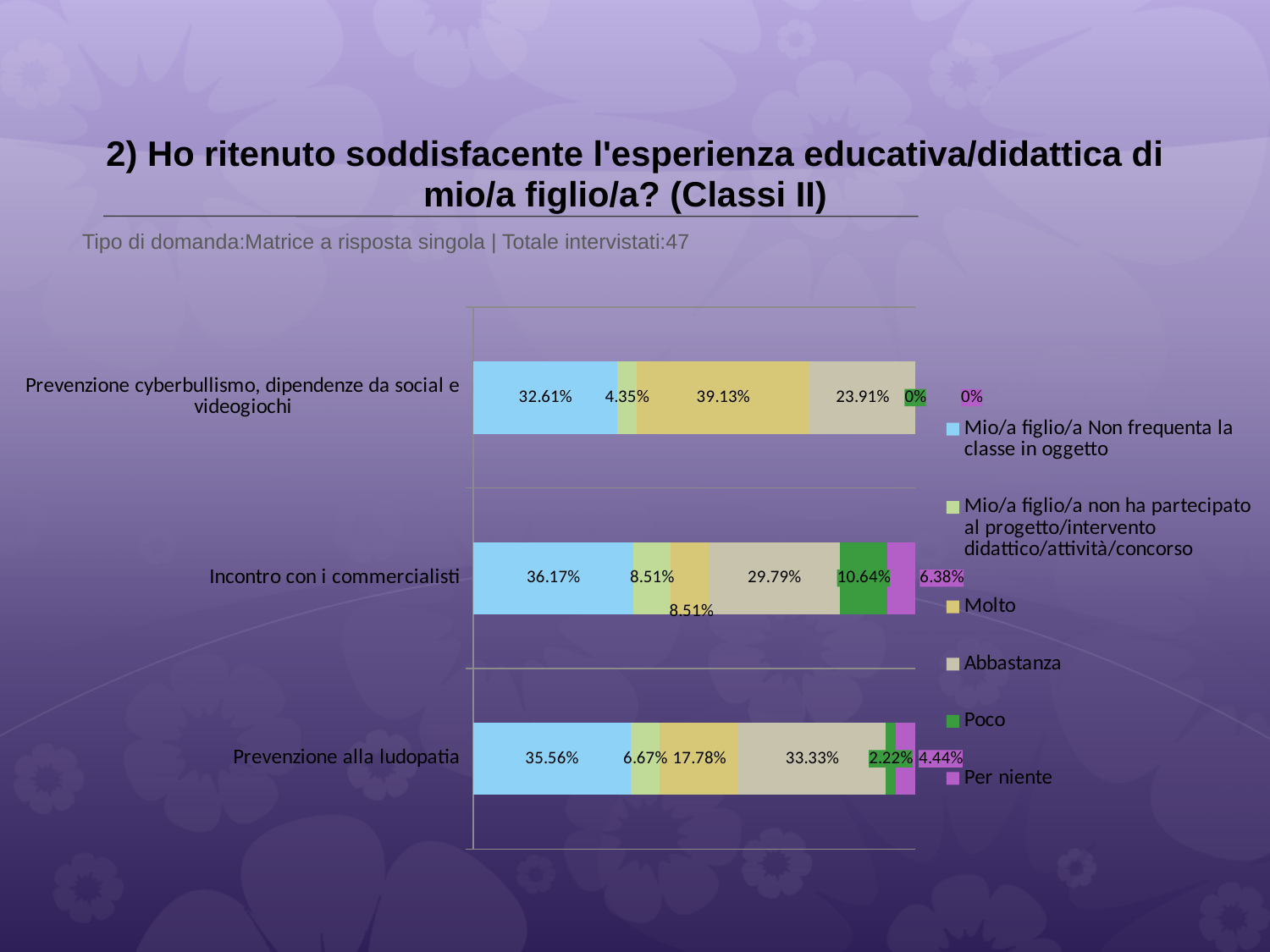
What is the value of "Per niente" for "Prevenzione alla ludopatia"? 4.44% What is the value of "Mio/a figlio/a non ha partecipato al progetto/intervento didattico/attività/concorso" for "Prevenzione alla ludopatia"? 6.67% How many series does the legend list? 6 How many categories are plotted on the chart? 3 Which category has the larger "Molto" value: "Prevenzione cyberbullismo, dipendenze da social e videogiochi" or "Prevenzione alla ludopatia"? Prevenzione cyberbullismo, dipendenze da social e videogiochi What kind of chart is shown on the slide? Stacked bar chart What is the value of "Poco" for "Incontro con i commercialisti"? 10.64% What colour represents the "Per niente" series in the legend? Purple What is the value of "Molto" for "Prevenzione cyberbullismo, dipendenze da social e videogiochi"? 39.13% Which category has the highest value for "Mio/a figlio/a Non frequenta la classe in oggetto"? Incontro con i commercialisti What is the difference between the "Abbastanza" values for "Prevenzione alla ludopatia" and "Incontro con i commercialisti"? 3.54% What is the value of "Abbastanza" for "Incontro con i commercialisti"? 29.79%